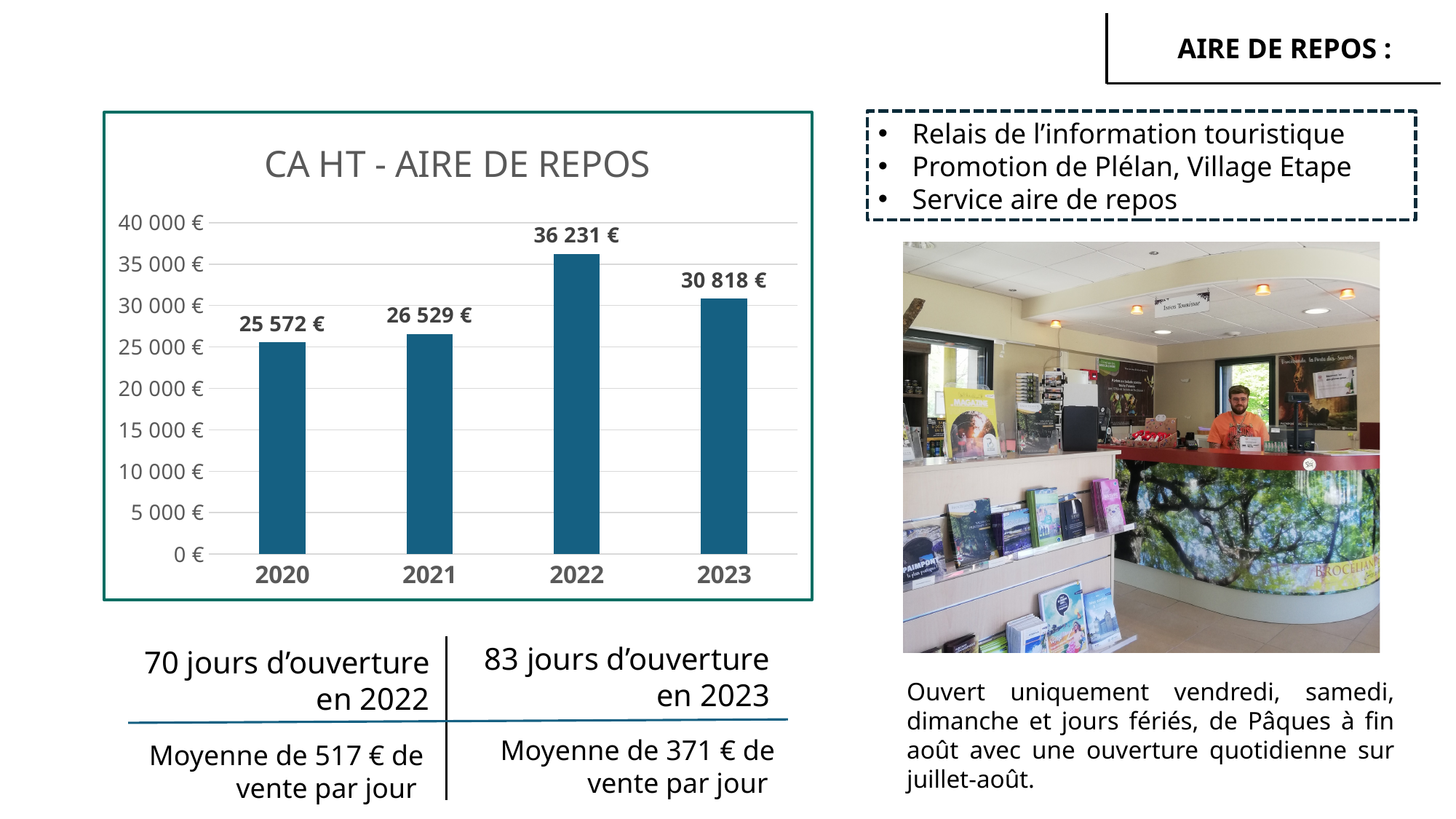
What kind of chart is the CA HT - AIRE DE REPOS chart? bar chart How many years are shown in the CA HT - AIRE DE REPOS chart? 4 Which year has the highest value in the CA HT - AIRE DE REPOS chart? 2022 What is the difference between the 2022 and 2021 values in the CA HT - AIRE DE REPOS chart? 9 702 € What is the difference between the 2022 and 2023 values in the CA HT - AIRE DE REPOS chart? 5 413 € Which year has the lowest value in the CA HT - AIRE DE REPOS chart? 2020 What is the value for 2022 in the CA HT - AIRE DE REPOS chart? 36 231 € What is the value for 2023 in the CA HT - AIRE DE REPOS chart? 30 818 € What is the value for 2020 in the CA HT - AIRE DE REPOS chart? 25 572 € What is the title of the chart on the slide? CA HT - AIRE DE REPOS Which is larger in the CA HT - AIRE DE REPOS chart, the value for 2021 or the value for 2023? 2023 Is the value for 2021 in the CA HT - AIRE DE REPOS chart greater or less than 30 000 €? less